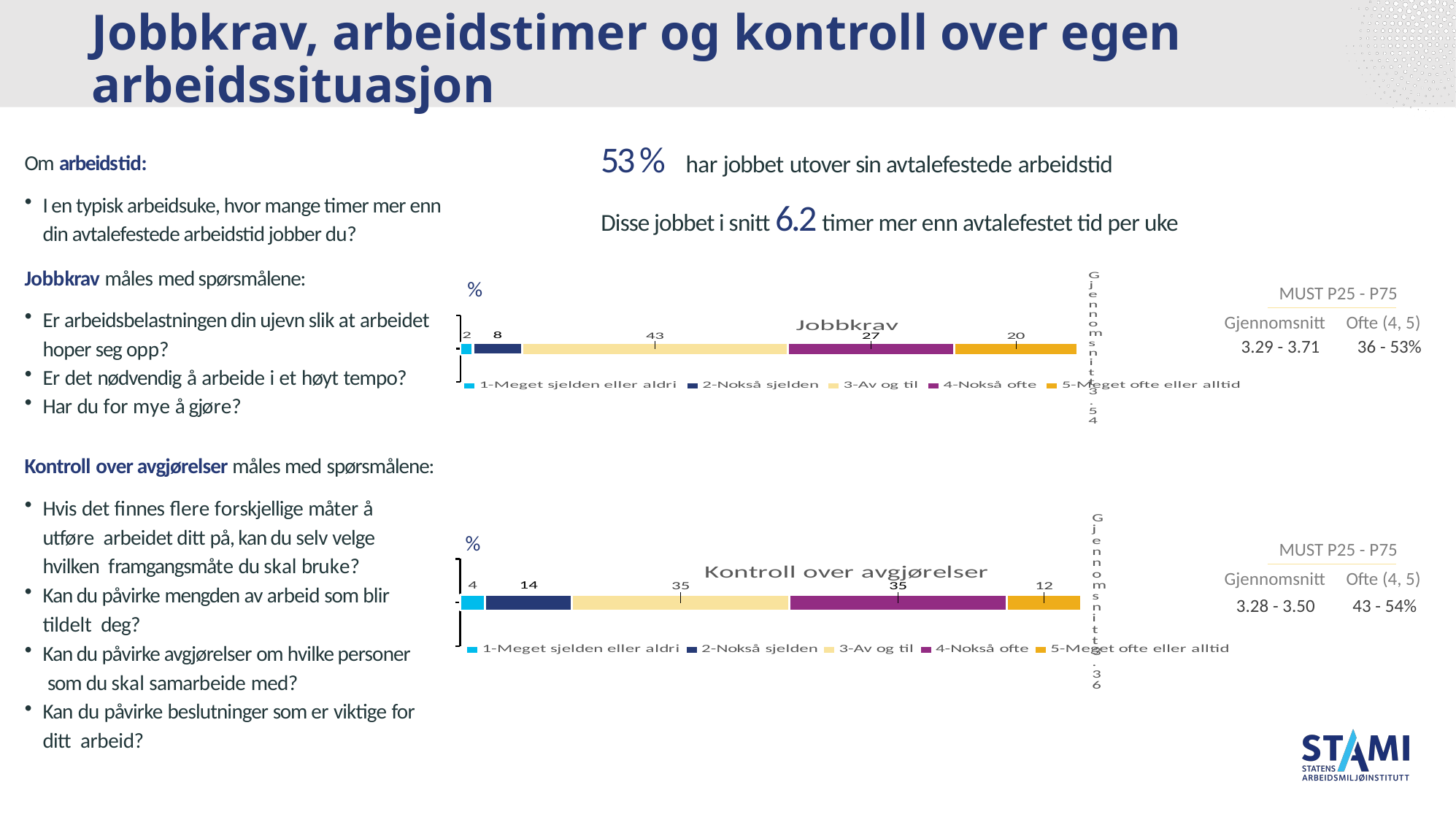
In the Jobbkrav chart, what is the value for the segment 5-Meget ofte eller alltid? 20 In the Jobbkrav chart, which legend category has the smallest segment? 1-Meget sjelden eller aldri In the Kontroll over avgjørelser chart, which legend category has the smallest segment? 1-Meget sjelden eller aldri In the Jobbkrav chart, which legend category has the largest segment? 3-Av og til How many series does the legend of the Jobbkrav chart list? 5 In the Kontroll over avgjørelser chart, what is the value for the segment 5-Meget ofte eller alltid? 12 In the Kontroll over avgjørelser chart, what is the value for the segment 2-Nokså sjelden? 14 In the Jobbkrav chart, what is the difference between the 3-Av og til segment and the 4-Nokså ofte segment? 16 In the Jobbkrav chart, what is the value for the segment 3-Av og til? 43 What type of chart is the Kontroll over avgjørelser chart? Stacked bar chart In the Kontroll over avgjørelser chart, which is larger: the 2-Nokså sjelden segment or the 5-Meget ofte eller alltid segment? 2-Nokså sjelden In the Kontroll over avgjørelser chart, what is the total of the stacked bar? 100